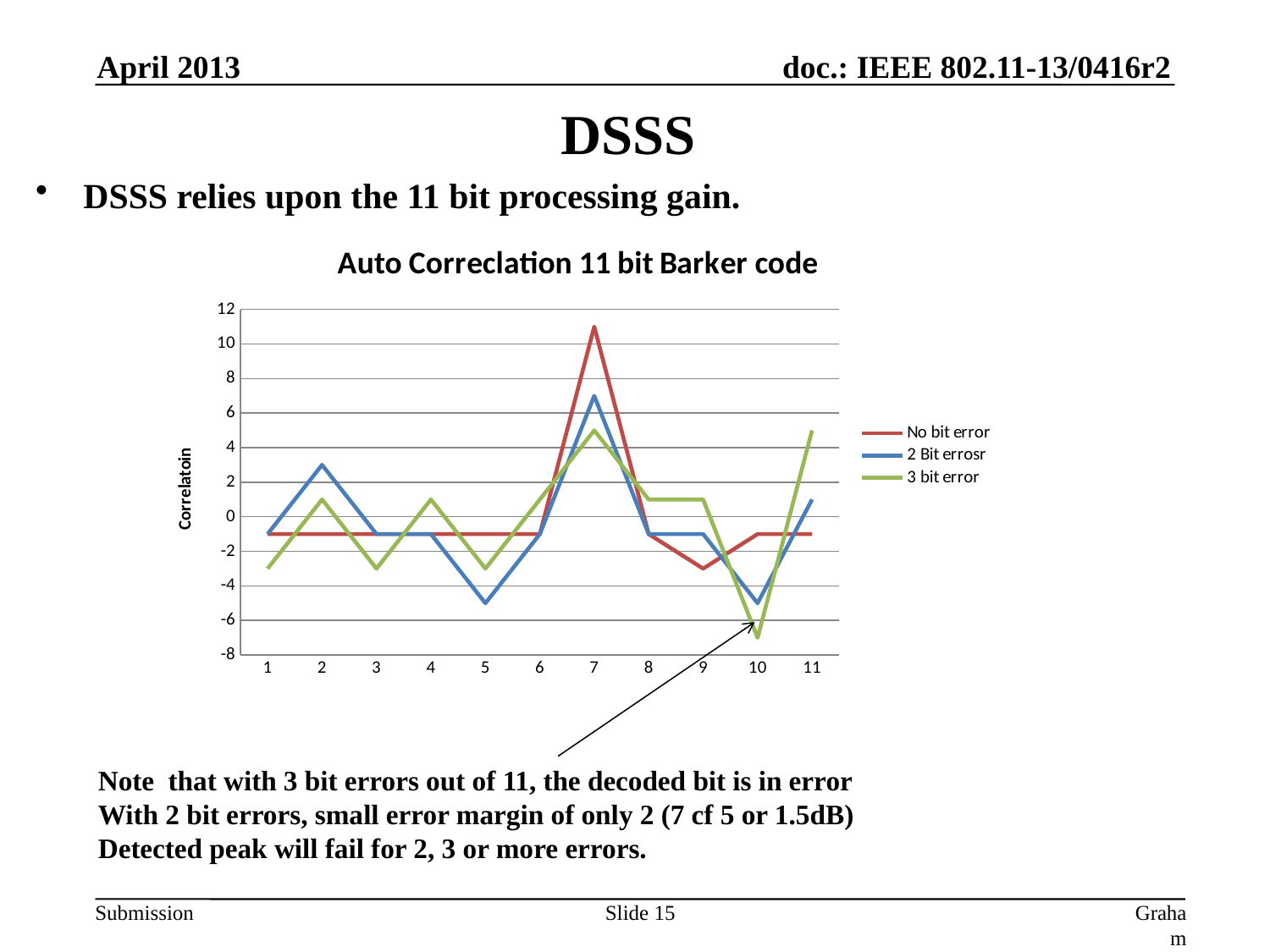
Is the value of the 2 Bit errosr series at x = 7 greater or less than 6? greater What kind of chart is shown on the slide? line chart What is the title of the chart? Auto Correclation 11 bit Barker code Is the value of the 3 bit error series at x = 10 greater or less than -6? less At x = 7, which series has the higher value, No bit error or 2 Bit errosr? No bit error Is the value of the No bit error series at x = 7 greater or less than 10? greater How many series does the chart legend list? 3 Which colour is used for the 3 bit error series? green How many points are plotted along the x axis for each series? 11 At which x-axis position does the 3 bit error series reach its lowest value? 10 At which x-axis position does the No bit error series reach its highest value? 7